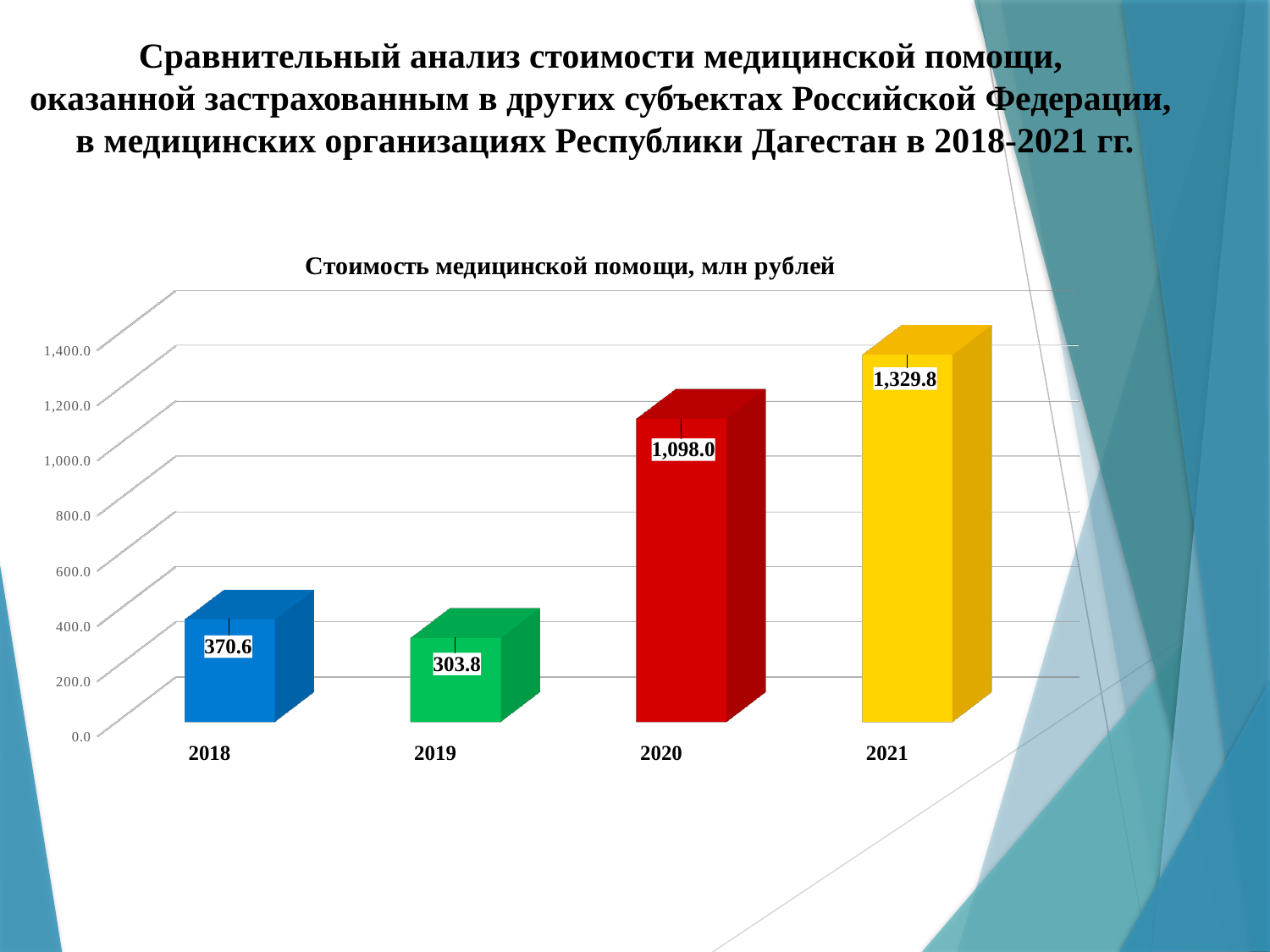
What is the value for 2020? 1,098.0 How many years are shown on the x axis? 4 What is the value for 2018? 370.6 What is the value for 2019? 303.8 What is the title of the chart? Стоимость медицинской помощи, млн рублей What kind of chart is shown on the slide? bar chart Which year has the lowest value? 2019 What is the difference between the values for 2021 and 2020? 231.8 Which year has the highest value? 2021 What is the difference between the values for 2018 and 2019? 66.8 Which is larger, the value for 2018 or the value for 2019? 2018 What is the value for 2021? 1,329.8